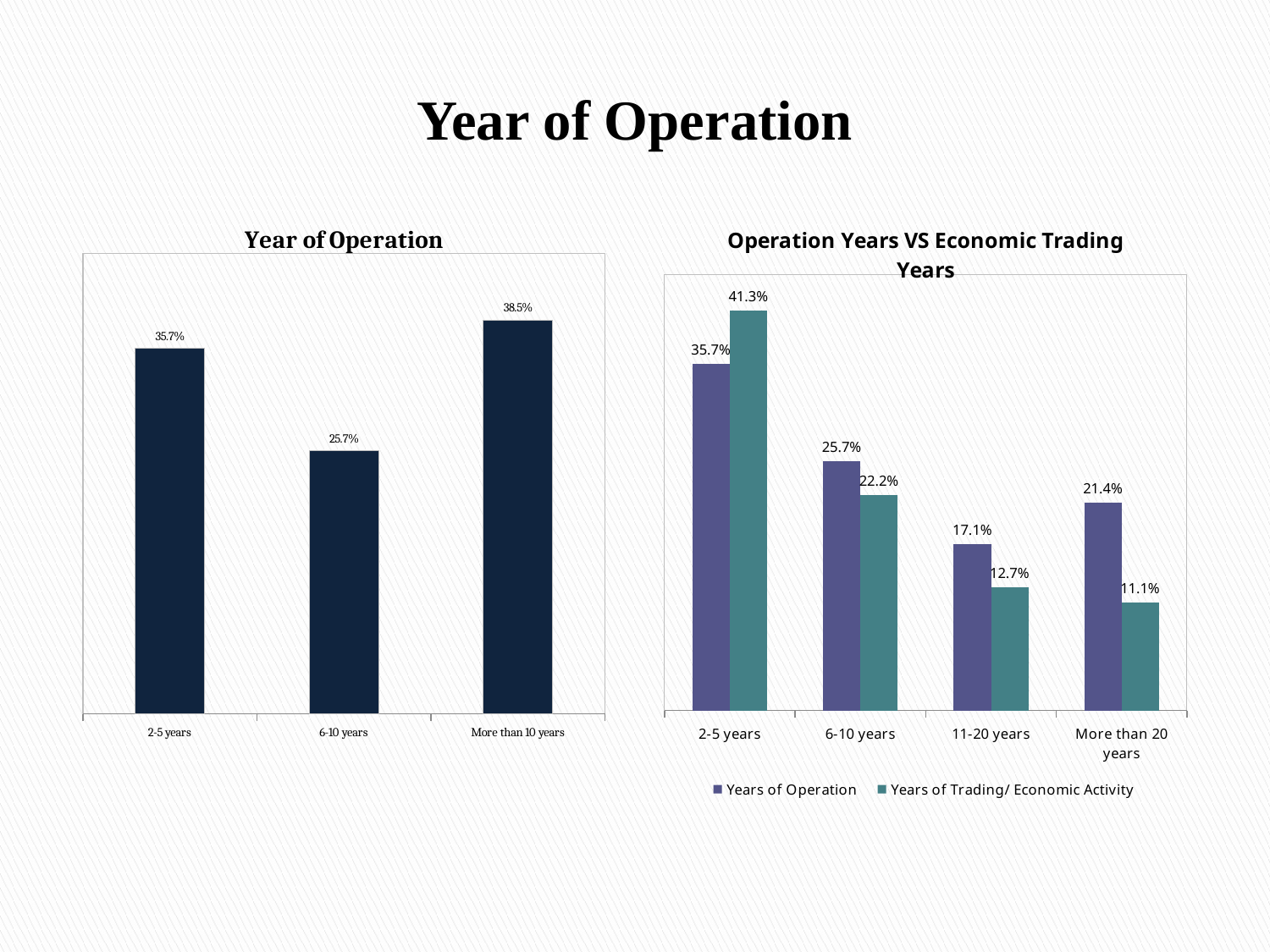
How many series does the legend of the 'Operation Years VS Economic Trading Years' chart list? 2 In the 'Year of Operation' chart on the left, which category has the lowest value? 6-10 years What kind of chart is the 'Year of Operation' chart on the left? Bar chart In the 'Operation Years VS Economic Trading Years' chart, what is the value of 'Years of Trading/ Economic Activity' for '2-5 years'? 41.3% In the 'Operation Years VS Economic Trading Years' chart, do the 'Years of Trading/ Economic Activity' values rise or fall from left to right across the categories? Fall In the 'Operation Years VS Economic Trading Years' chart, which is larger for '6-10 years': 'Years of Operation' or 'Years of Trading/ Economic Activity'? Years of Operation How many categories are shown in the 'Year of Operation' chart on the left? 3 In the 'Year of Operation' chart on the left, what is the difference between 'More than 10 years' and '2-5 years'? 2.8% In the 'Year of Operation' chart on the left, what is the value for 'More than 10 years'? 38.5% In the 'Operation Years VS Economic Trading Years' chart, which category has the lowest 'Years of Trading/ Economic Activity' value? More than 20 years In the 'Operation Years VS Economic Trading Years' chart, what is the value of 'Years of Operation' for '11-20 years'? 17.1% In the 'Operation Years VS Economic Trading Years' chart, what is the difference between 'Years of Operation' and 'Years of Trading/ Economic Activity' for 'More than 20 years'? 10.3%